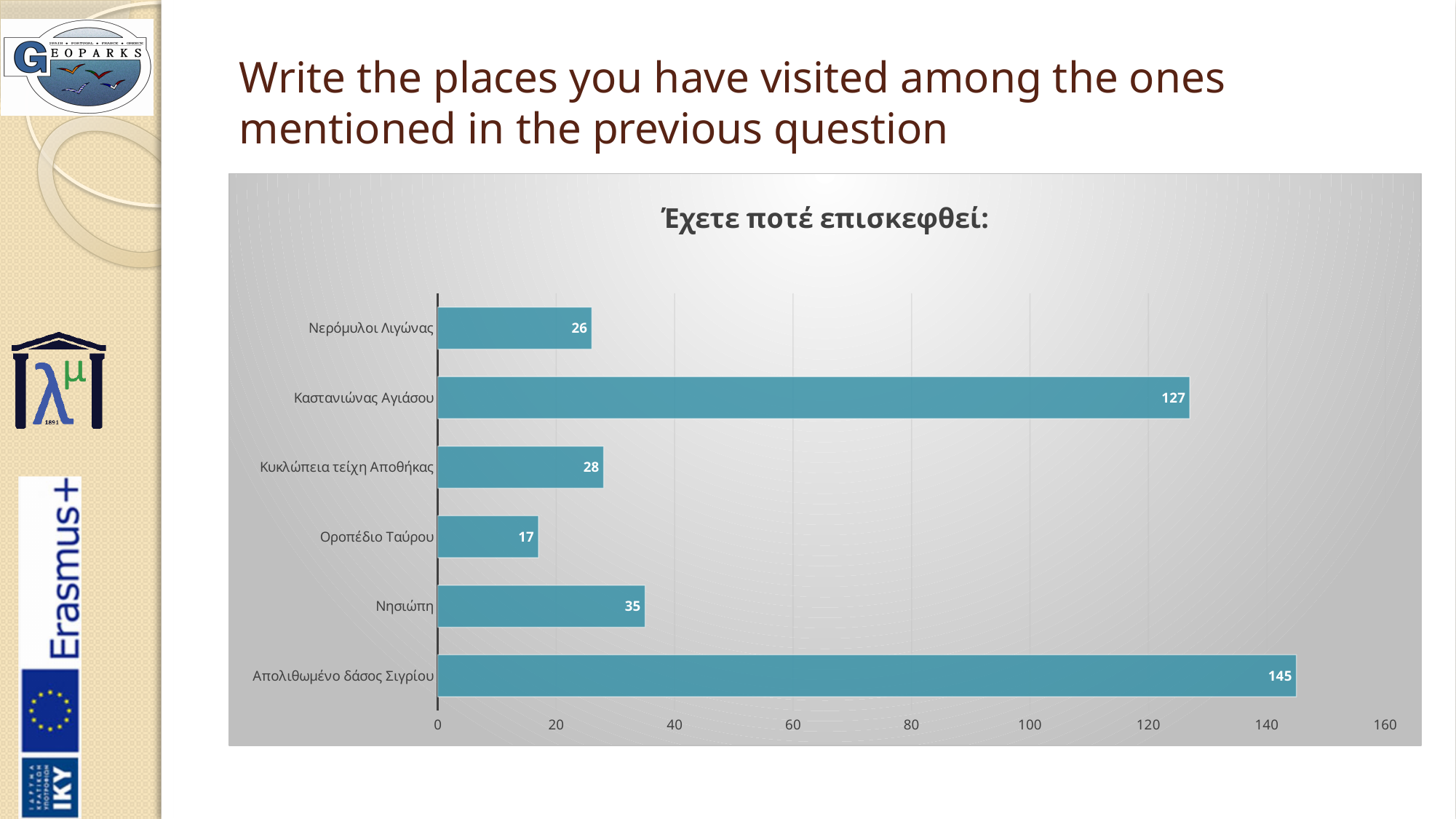
What is the difference between the values for Απολιθωμένο δάσος Σιγρίου and Καστανιώνας Αγιάσου? 18 Which category has the lowest value? Οροπέδιο Ταύρου What kind of chart is shown on the slide? Bar chart Is the value for Καστανιώνας Αγιάσου greater or less than 100? greater What is the value for Απολιθωμένο δάσος Σιγρίου? 145 What is the value for Οροπέδιο Ταύρου? 17 What is the value for Νησιώπη? 35 What is the value for Καστανιώνας Αγιάσου? 127 Which category has the highest value? Απολιθωμένο δάσος Σιγρίου Which is larger, the value for Νησιώπη or the value for Κυκλώπεια τείχη Αποθήκας? Νησιώπη What is the title of the chart? Έχετε ποτέ επισκεφθεί: How many categories are shown in the chart? 6